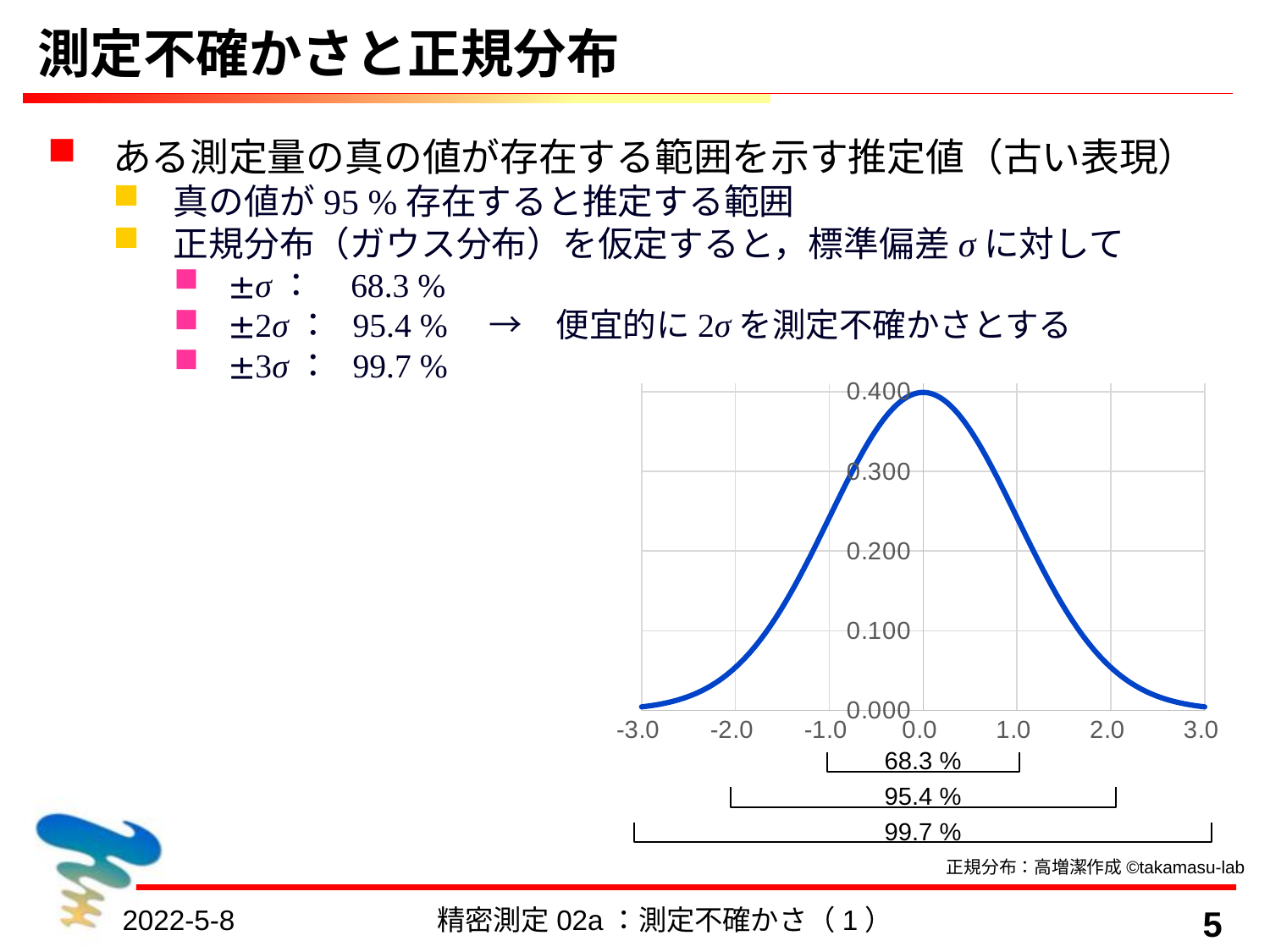
Is the value of the curve at x = 1.0 greater or less than 0.200? greater Does the curve rise or fall as x goes from -3.0 to 0.0? rise At which x-axis value does the curve reach its highest point? 0.0 How many tick labels are shown on the x axis? 7 Is the value of the curve at x = 2.0 greater or less than 0.100? less Is the value of the curve at x = 0.0 greater or less than 0.300? greater What kind of chart is shown on the slide? line chart Which has the larger value on the curve, x = 1.0 or x = 2.0? 1.0 Does the curve rise or fall as x goes from 0.0 to 3.0? fall What percentage label is shown under the chart for the range from -1.0 to 1.0? 68.3 % What percentage label is shown under the chart for the widest bracket, from -3.0 to 3.0? 99.7 %